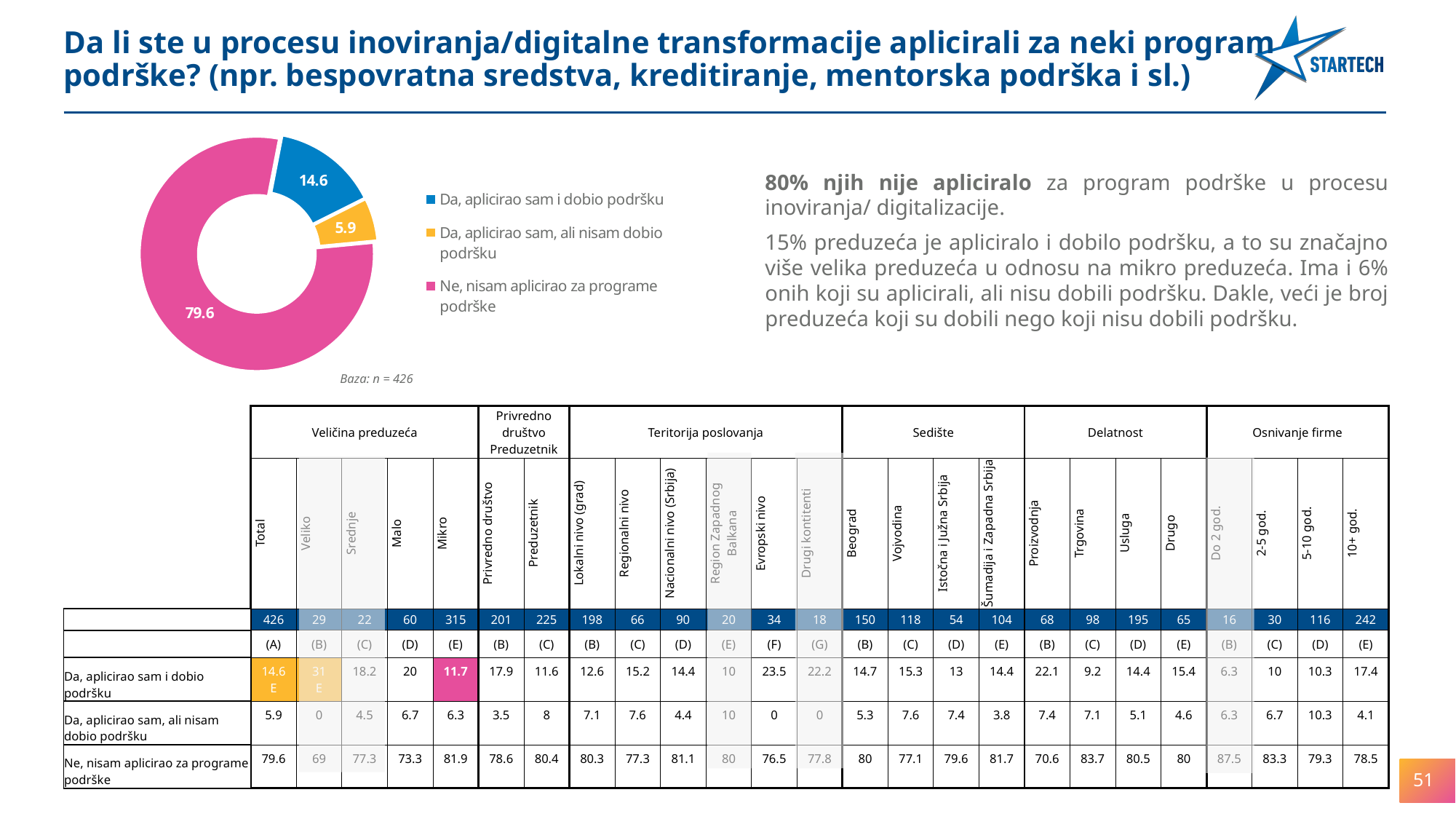
What is the difference between the values for "Da, aplicirao sam i dobio podršku" and "Da, aplicirao sam, ali nisam dobio podršku"? 8.7 How many entries does the legend of the doughnut chart list? 3 What is the value for "Da, aplicirao sam i dobio podršku" in the doughnut chart? 14.6 What colour is the slice for "Ne, nisam aplicirao za programe podrške" in the doughnut chart? Pink Which category has the smallest slice in the doughnut chart? Da, aplicirao sam, ali nisam dobio podršku How many slices does the doughnut chart have? 3 What kind of chart is shown on the slide? Doughnut (pie) chart Which is larger: the slice for "Da, aplicirao sam i dobio podršku" or the slice for "Da, aplicirao sam, ali nisam dobio podršku"? Da, aplicirao sam i dobio podršku What is the base (n) stated below the doughnut chart? n = 426 Which category has the largest slice in the doughnut chart? Ne, nisam aplicirao za programe podrške What is the value for "Da, aplicirao sam, ali nisam dobio podršku" in the doughnut chart? 5.9 What is the value for "Ne, nisam aplicirao za programe podrške" in the doughnut chart? 79.6